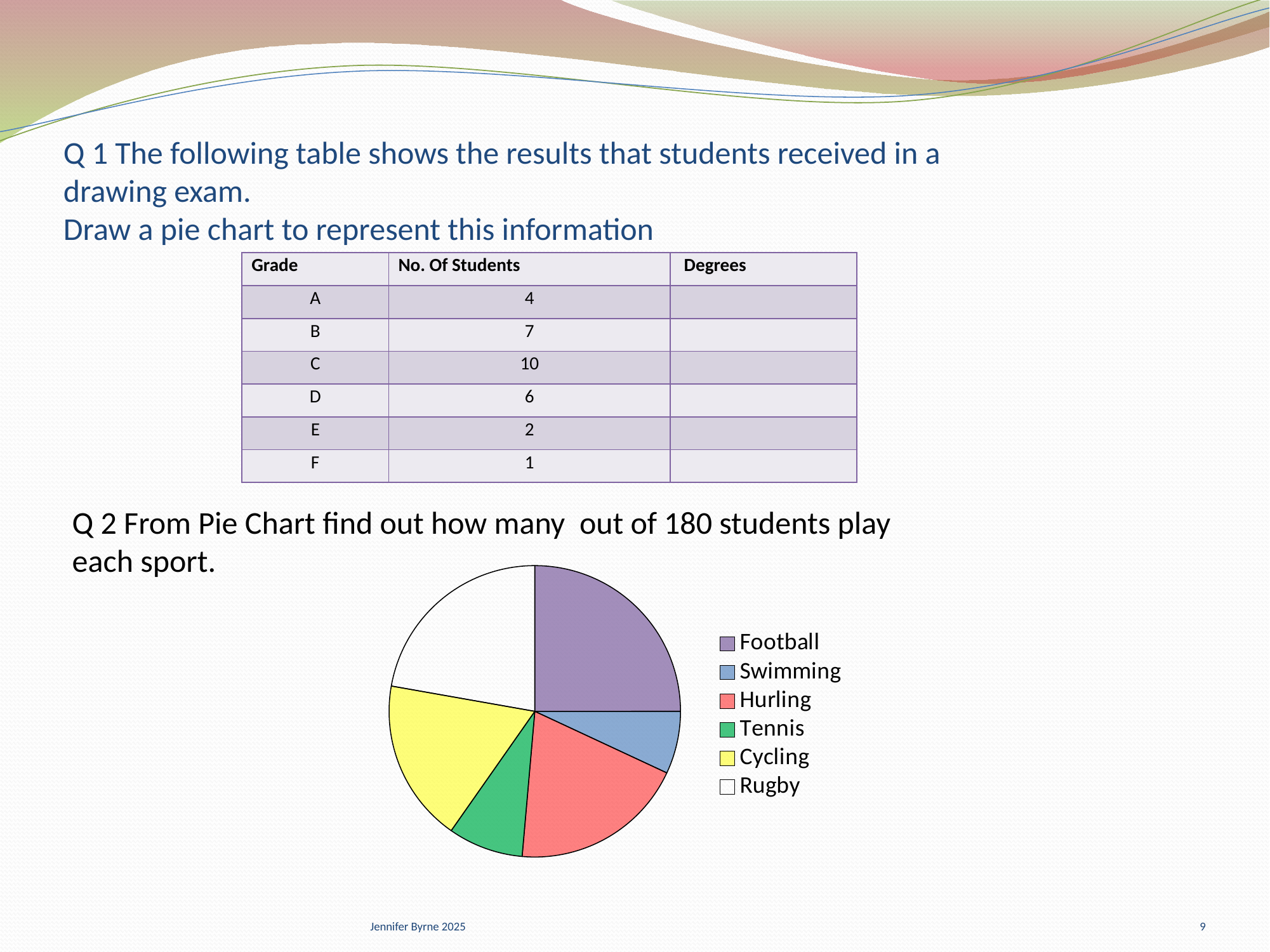
Which slice is larger in the pie chart, Football or Tennis? Football Which slice is larger in the pie chart, Hurling or Tennis? Hurling Which slice is larger in the pie chart, Rugby or Swimming? Rugby Which sport is shown in yellow in the pie chart? Cycling What kind of chart is shown on the slide? pie chart Which sport has the smallest slice in the pie chart? Swimming How many sports are shown in the pie chart? 6 What colour is the Football slice in the pie chart? purple